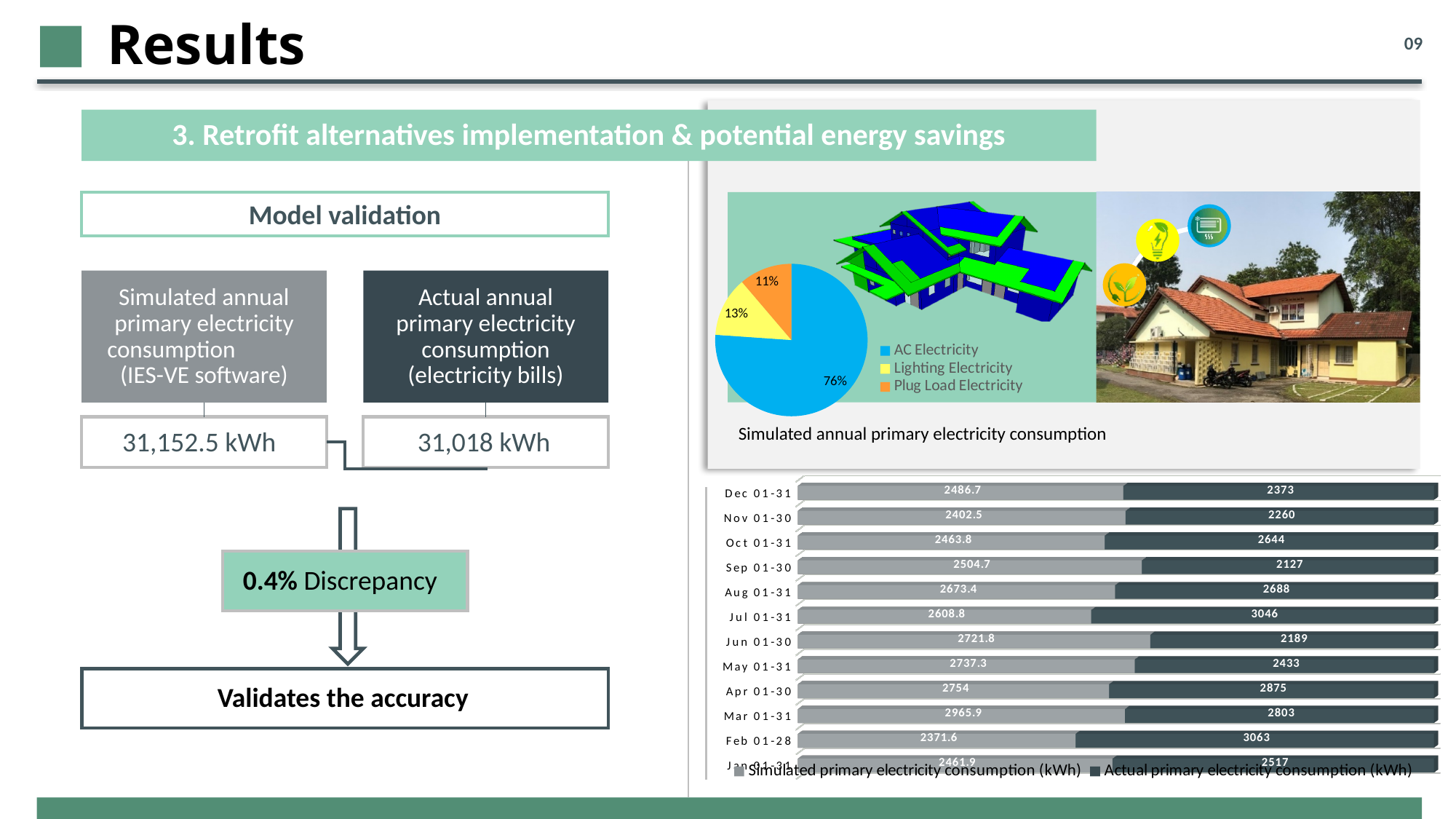
In the monthly bar chart at the bottom right, what is the simulated primary electricity consumption for Jul 01-31? 2608.8 In the monthly bar chart at the bottom right, what is the actual primary electricity consumption for Feb 01-28? 3063 In the monthly bar chart at the bottom right, how many series does the legend list? 2 In the pie chart titled 'Simulated annual primary electricity consumption', which category has the smallest share? Plug Load Electricity In the monthly bar chart at the bottom right, what is the difference between the actual and simulated primary electricity consumption for Jun 01-30? 532.8 In the monthly bar chart at the bottom right, which month has the highest simulated primary electricity consumption? Mar 01-31 In the monthly bar chart at the bottom right, which month has the lowest actual primary electricity consumption? Sep 01-30 In the pie chart titled 'Simulated annual primary electricity consumption', what share does Plug Load Electricity have? 11% In the pie chart titled 'Simulated annual primary electricity consumption', what share does AC Electricity have? 76% What kind of chart is the monthly chart at the bottom right of the slide? Stacked bar chart In the pie chart titled 'Simulated annual primary electricity consumption', how many slices are there? 3 In the monthly bar chart at the bottom right, is the simulated or the actual primary electricity consumption larger for Oct 01-31? Actual primary electricity consumption (kWh)